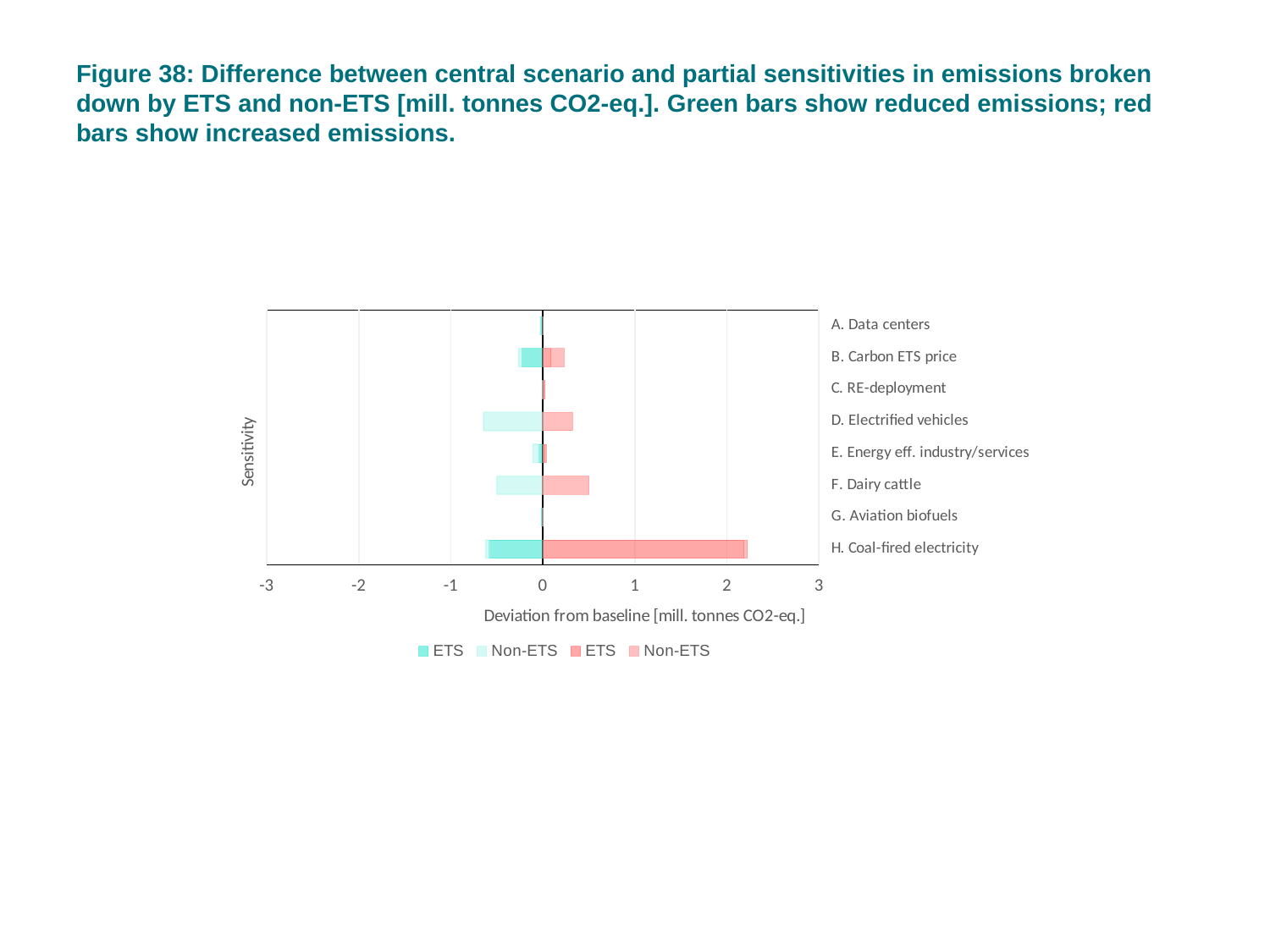
Is the green Non-ETS value for D. Electrified vehicles greater or less than -1? greater Which sensitivity has the longest red (increased emissions) bar? H. Coal-fired electricity How many sensitivity categories are plotted on the chart? 8 What is the title of the y axis? Sensitivity Which has the larger red bar: H. Coal-fired electricity or D. Electrified vehicles? H. Coal-fired electricity Is the red Non-ETS value for F. Dairy cattle greater or less than 1? less How many entries does the chart legend list? 4 What kind of chart is shown on the slide? bar chart What is the title of the x axis? Deviation from baseline [mill. tonnes CO2-eq.] Is the red ETS value for H. Coal-fired electricity greater or less than 2? greater Which has the larger red bar: F. Dairy cattle or B. Carbon ETS price? F. Dairy cattle